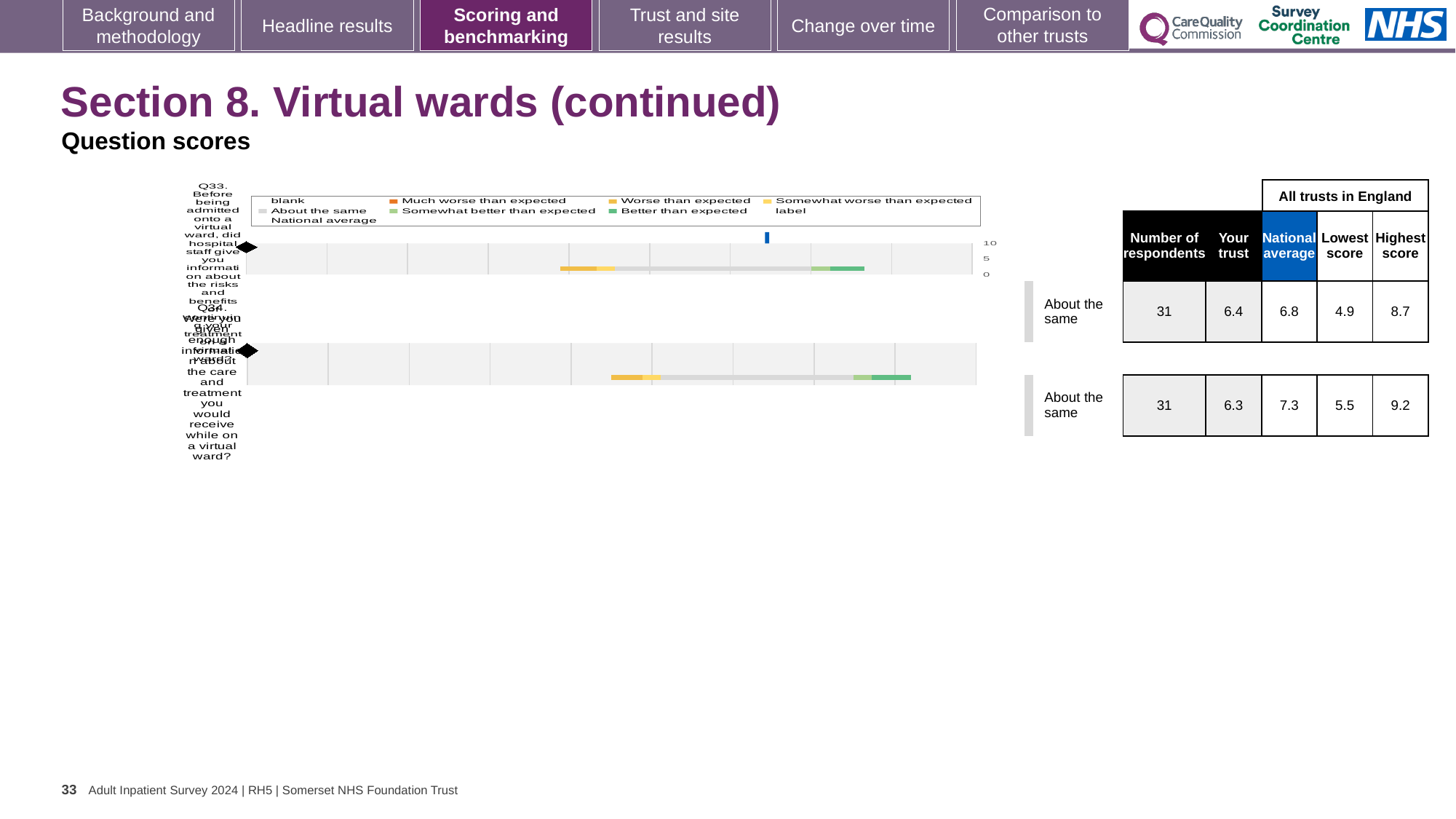
How many questions (bars) are plotted in the chart? 2 What kind of chart is shown on the slide? bar chart Which question has the higher 'Your trust' score in the table, Q33 or Q34? Q33 What is the difference between the national average and the 'Your trust' score for Q34 in the table? 1.0 What colour does the legend use for 'Better than expected'? green In the table next to the chart, what is the national average for Q34? 7.3 What benchmark category label is shown for Q33 next to the chart? About the same In the table next to the chart, what is the highest score for Q34? 9.2 In the table next to the chart, what is the 'Your trust' score for Q33? 6.4 In the table next to the chart, how many respondents are listed for Q33? 31 What colour does the legend use for 'Much worse than expected'? orange How many entries does the chart legend list? 9